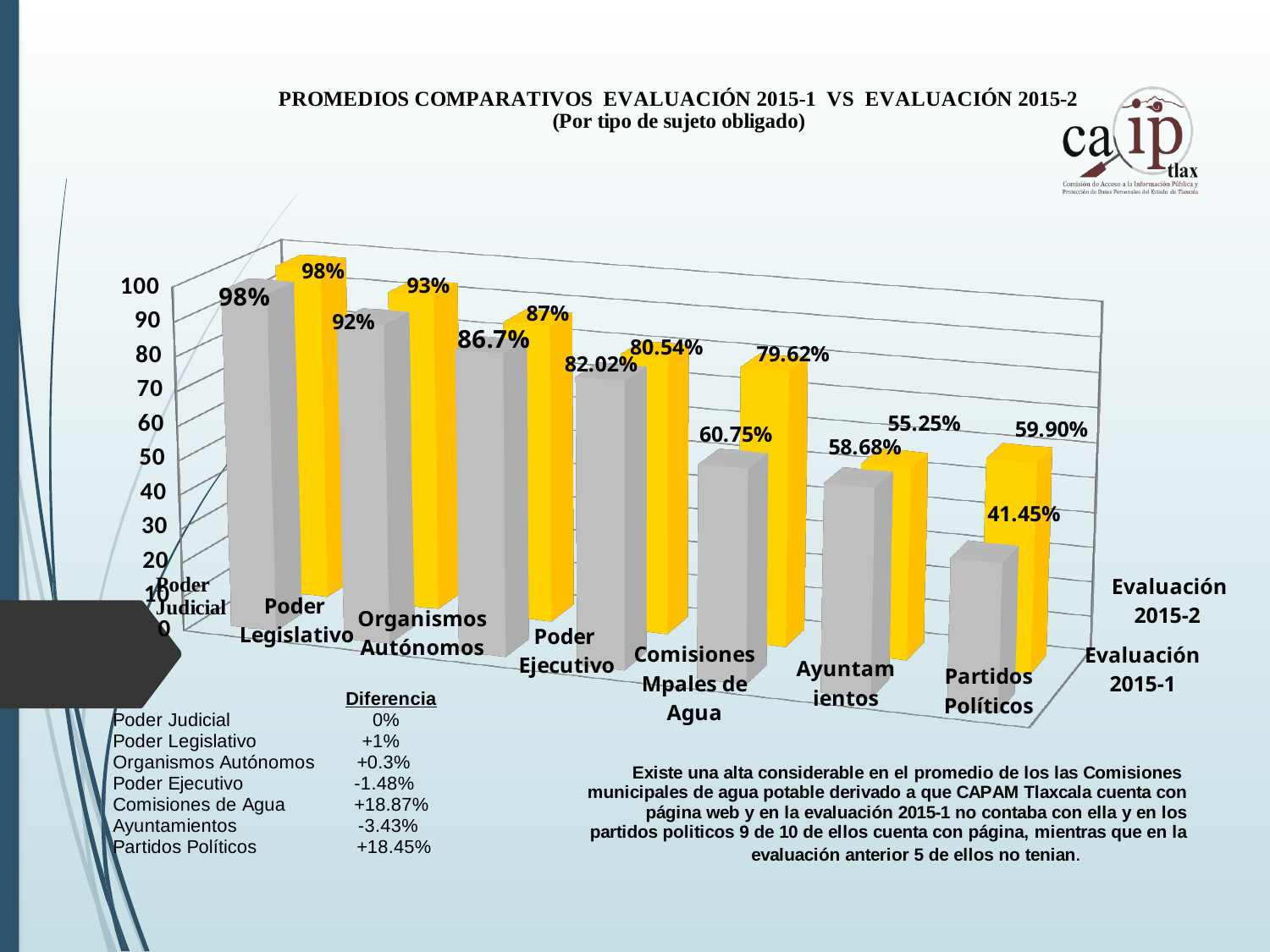
Which is larger for Ayuntamientos: the Evaluación 2015-1 value or the Evaluación 2015-2 value? Evaluación 2015-1 What is the Evaluación 2015-1 value for Partidos Políticos? 41.45% What is the Evaluación 2015-2 value for Comisiones Mpales de Agua? 79.62% Which colour represents the Evaluación 2015-2 series? Yellow Which category has the lowest Evaluación 2015-1 value? Partidos Políticos What is the Evaluación 2015-1 value for Poder Ejecutivo? 82.02% Which category has the highest Evaluación 2015-2 value? Poder Judicial What kind of chart is shown on the slide? Bar chart How many series does the chart show? 2 What is the Evaluación 2015-2 value for Ayuntamientos? 55.25% How many categories (types of sujeto obligado) are shown on the chart? 7 What is the difference between the Evaluación 2015-2 and Evaluación 2015-1 values for Partidos Políticos? 18.45%